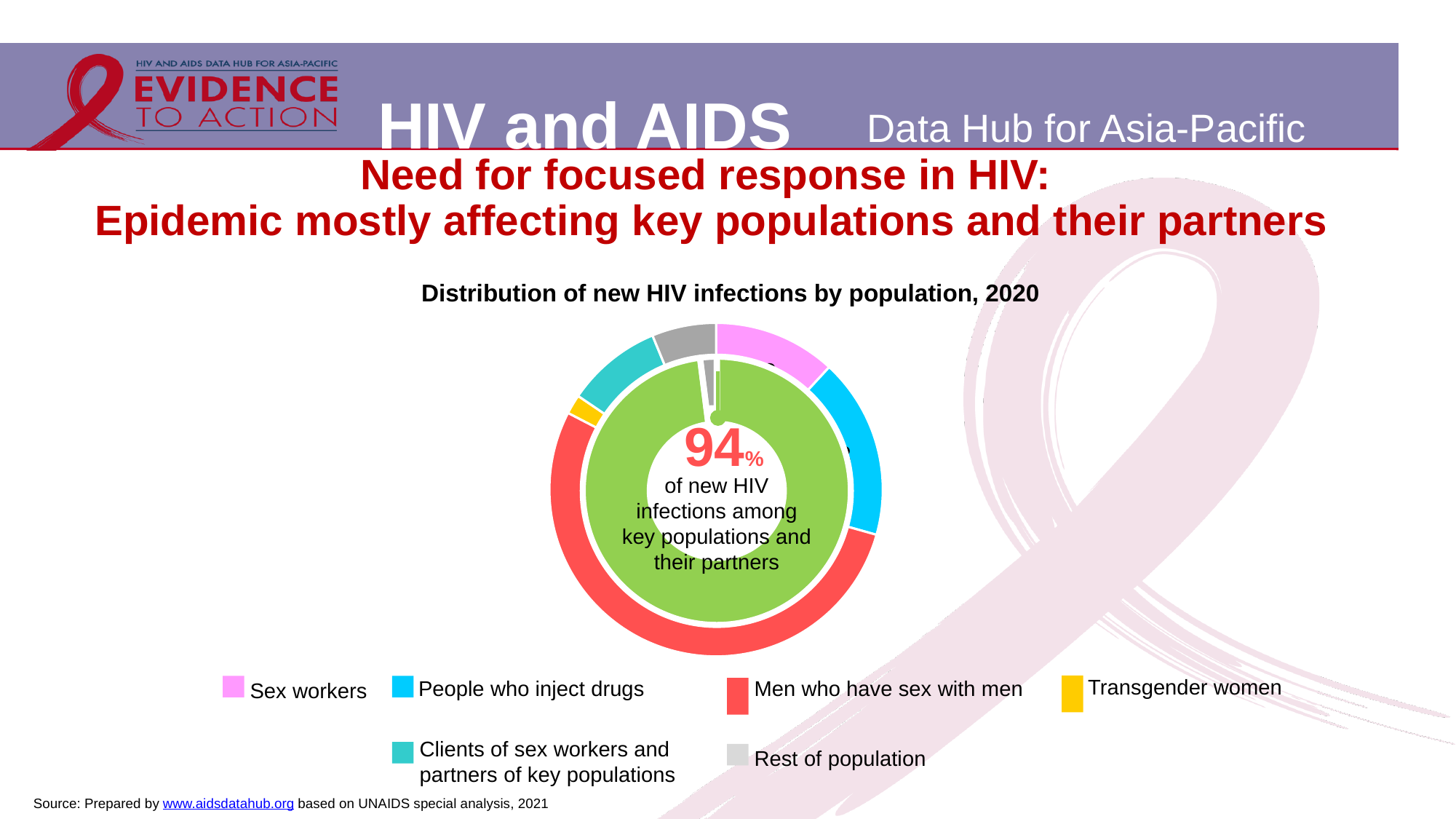
What is the title of the chart? Distribution of new HIV infections by population, 2020 Which slice is larger: People who inject drugs or Sex workers? People who inject drugs What colour represents Sex workers in the chart? pink Which slice is larger: People who inject drugs or Transgender women? People who inject drugs What kind of chart is shown on the slide? pie chart (donut) Which population accounts for the smallest share of new HIV infections in the chart? Transgender women How many population categories does the chart show? 6 What percentage of new HIV infections is shown in the centre of the chart as being among key populations and their partners? 94% Which population accounts for the largest share of new HIV infections in the chart? Men who have sex with men Which slice is larger: Men who have sex with men or Sex workers? Men who have sex with men How many entries does the legend list? 6